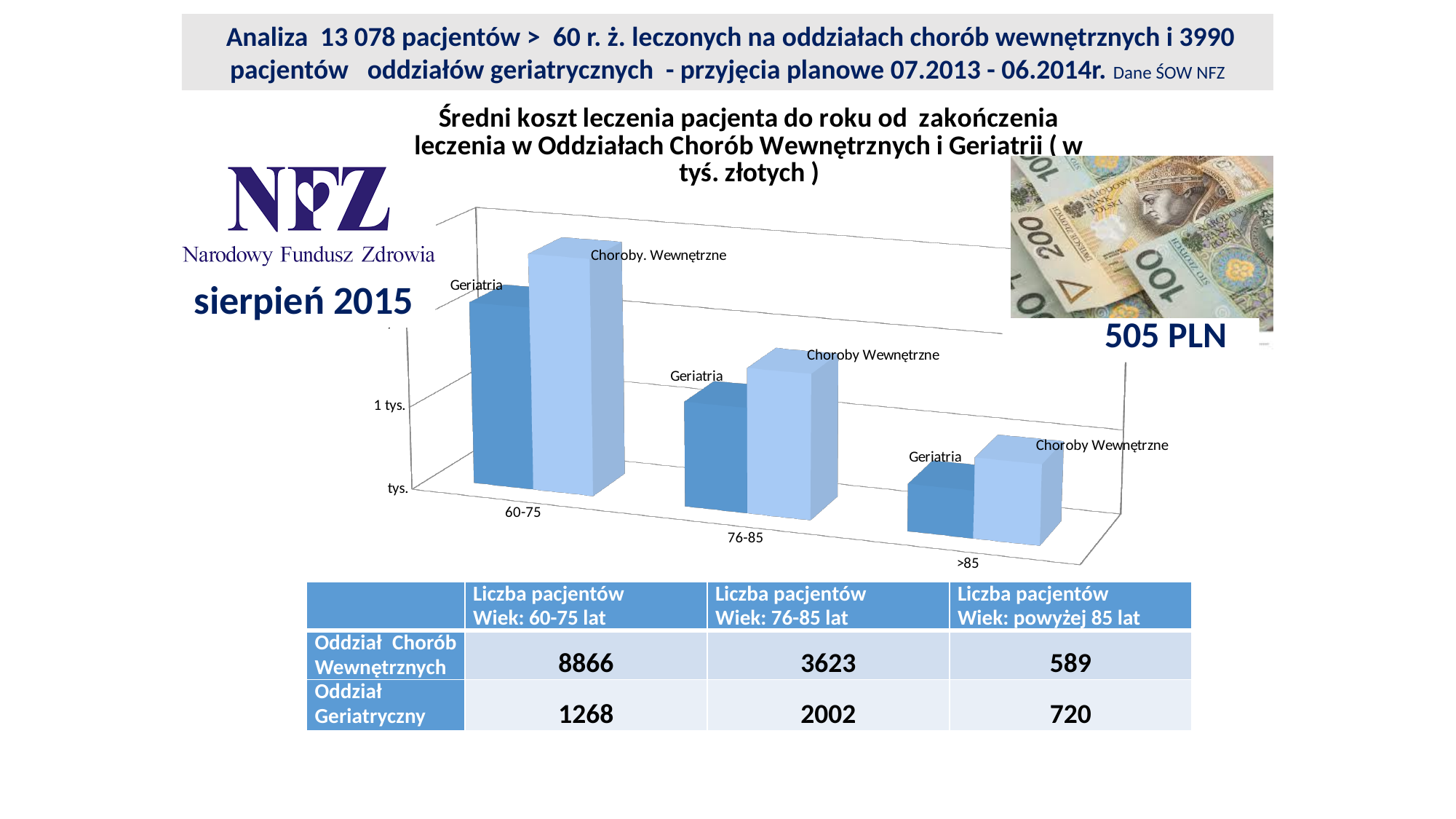
In the 76-85 age group, which series has the larger value, Geriatria or Choroby Wewnętrzne? Choroby Wewnętrzne How many series are plotted in the chart? 2 What unit does the chart title say the values are expressed in? tyś. złotych What kind of chart is shown on the slide? bar chart What are the names of the two series plotted in the chart? Geriatria and Choroby Wewnętrzne Is the value for Choroby Wewnętrzne in the 60-75 age group greater or less than 1 tys.? greater Which age group has the lowest bars in the chart? >85 How many age-group categories are shown on the x axis of the chart? 3 Do the values for Geriatria rise or fall as the age group increases from 60-75 to >85? fall In the >85 age group, which series has the larger value, Geriatria or Choroby Wewnętrzne? Choroby Wewnętrzne Which age group has the highest bars in the chart? 60-75 In the 60-75 age group, which series has the larger value, Geriatria or Choroby Wewnętrzne? Choroby Wewnętrzne